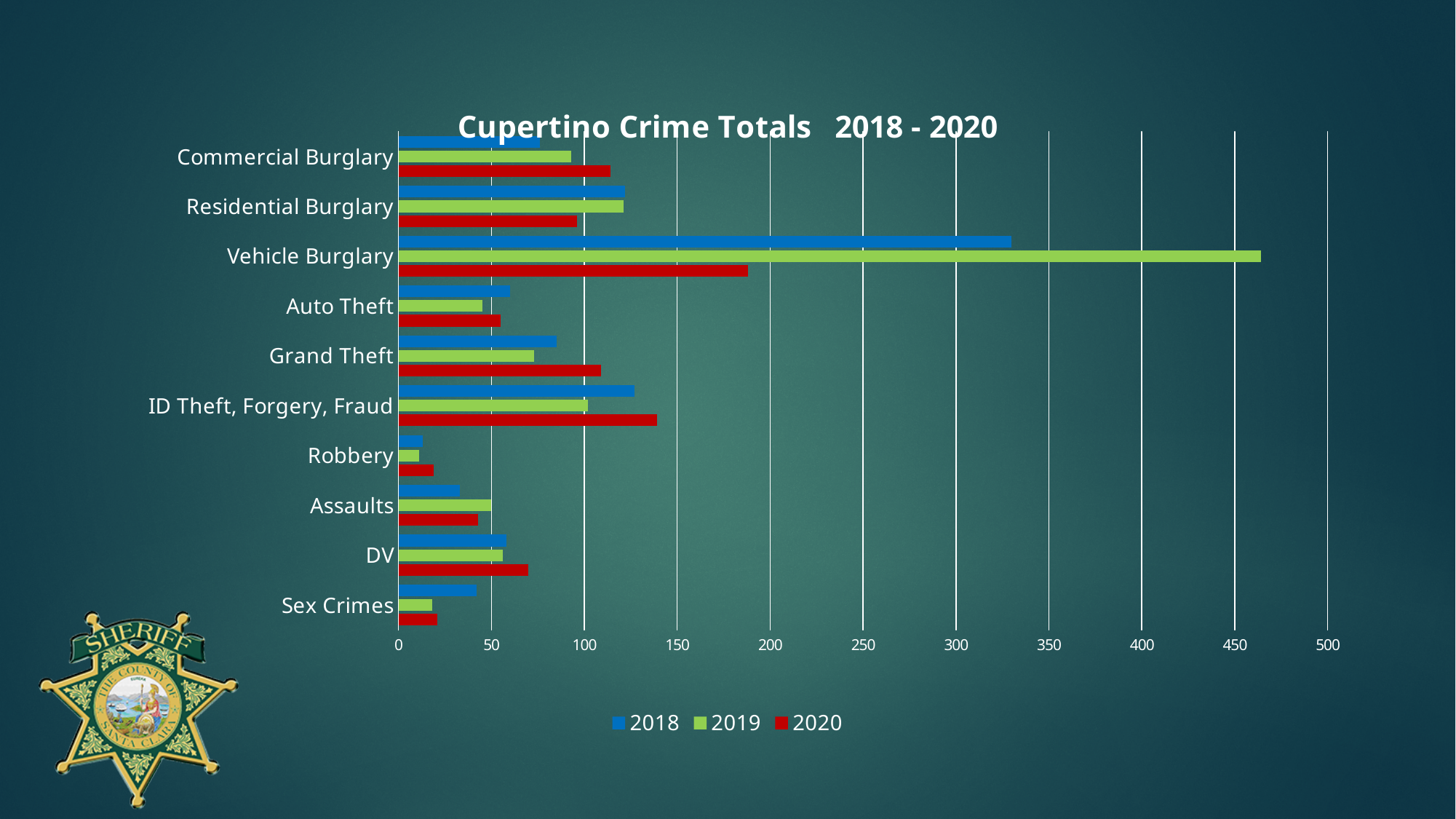
What kind of chart is shown on the slide? bar chart What is the title of the chart? Cupertino Crime Totals 2018 - 2020 Is the 2018 value for Vehicle Burglary greater or less than 300? greater Is the 2020 value for Vehicle Burglary greater or less than 200? less Is the 2019 value for Vehicle Burglary greater or less than 450? greater How many crime categories are shown on the chart? 10 For ID Theft, Forgery, Fraud, which year has the larger value, 2019 or 2020? 2020 Which crime category has the lowest value for 2019? Robbery What colour represents the 2020 series in the legend? red Which crime category has the highest value for 2019? Vehicle Burglary How many series does the legend list? 3 For Vehicle Burglary, which year has the larger value, 2018 or 2020? 2018